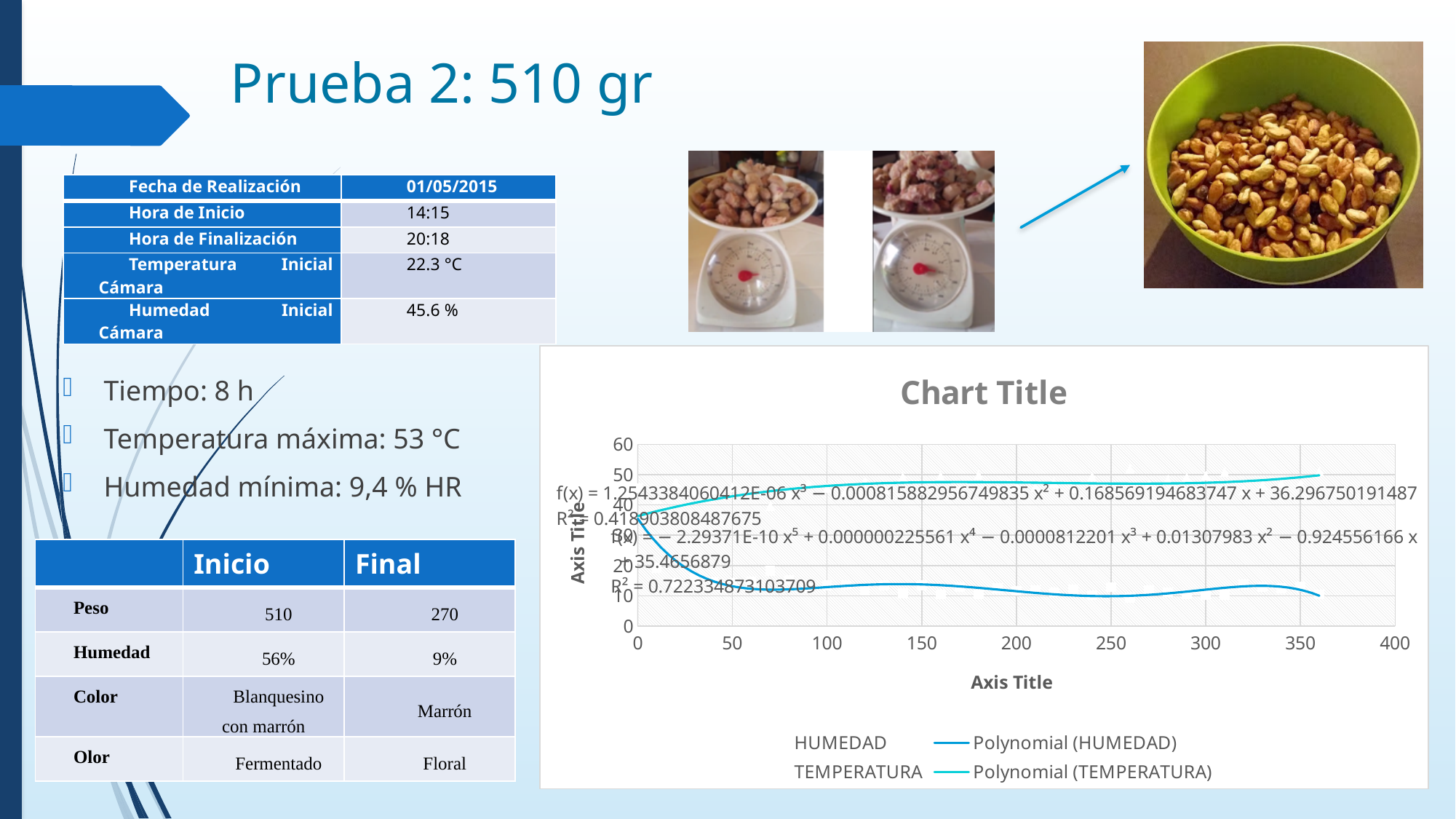
Does the polynomial trendline for TEMPERATURA rise or fall as x increases from 0 to 350? rise Which series has higher values across the chart, HUMEDAD or TEMPERATURA? TEMPERATURA Is the TEMPERATURA trendline value at x = 200 greater or less than 40? greater What is the highest value shown on the chart's x axis? 400 What is the R² value shown for the HUMEDAD polynomial trendline (the fifth-degree polynomial)? 0.722334873103709 Which two data series are plotted in the chart? HUMEDAD and TEMPERATURA Is the HUMEDAD trendline value at x = 200 greater or less than 20? less How many entries does the chart legend list? 4 What is the title of the chart? Chart Title Is the HUMEDAD trendline value at x = 0 greater or less than 30? greater Does the polynomial trendline for HUMEDAD rise or fall overall as x increases from 0 to 350? fall